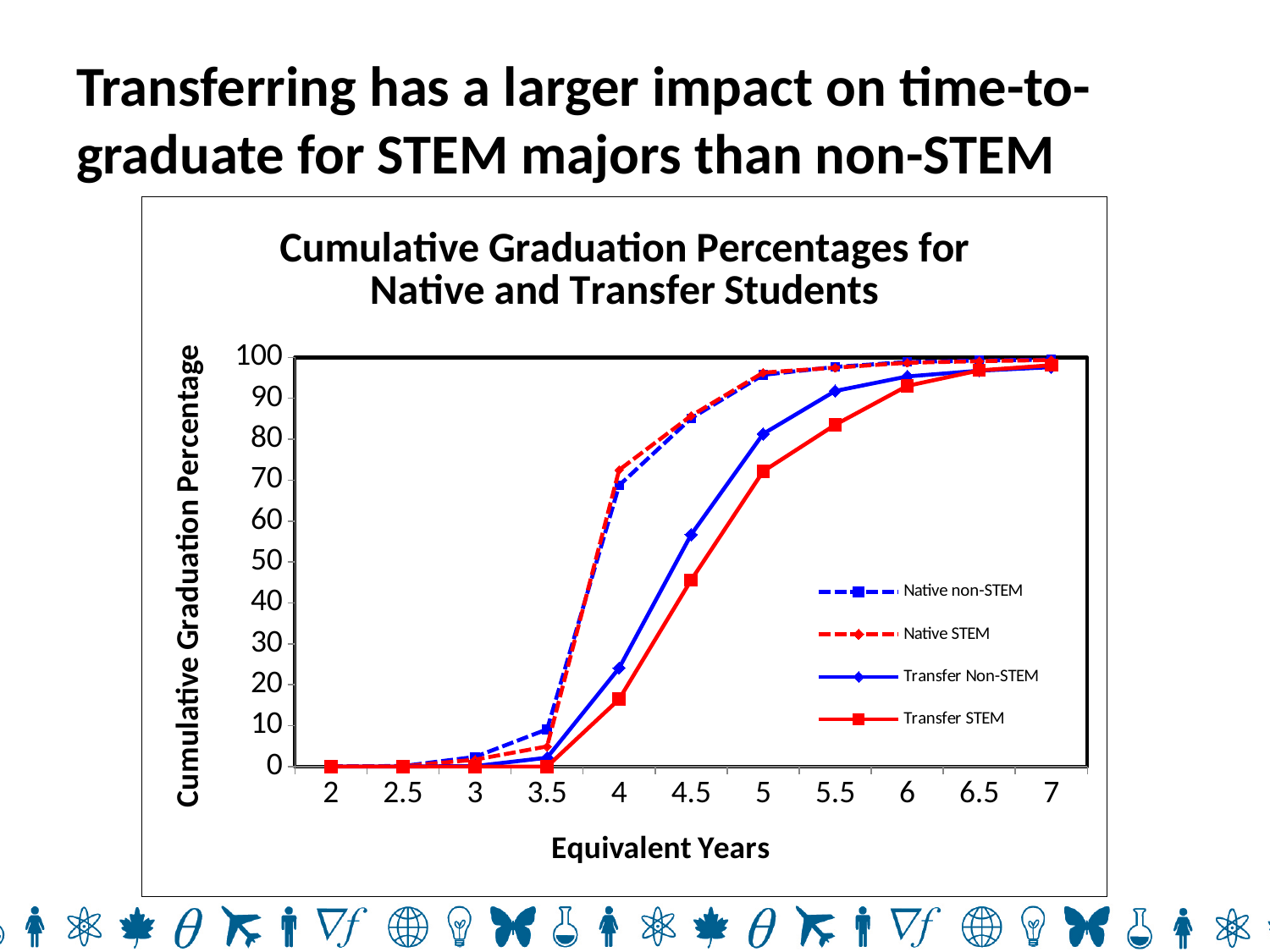
How many points along the Equivalent Years axis does each series have? 11 Is the value for Transfer STEM at 4 equivalent years greater or less than 20? less How many series does the chart's legend list? 4 Is the value for Transfer STEM at 5.5 equivalent years greater or less than 80? greater What is the label of the vertical axis? Cumulative Graduation Percentage What is the title of the chart? Cumulative Graduation Percentages for Native and Transfer Students Is the value for Native STEM at 4 equivalent years greater or less than 60? greater At 4.5 equivalent years, which is larger: Transfer Non-STEM or Transfer STEM? Transfer Non-STEM What kind of chart is shown on the slide? line chart Do the values for Transfer STEM rise or fall as Equivalent Years increase? rise Which series has the lowest value at 5 equivalent years? Transfer STEM